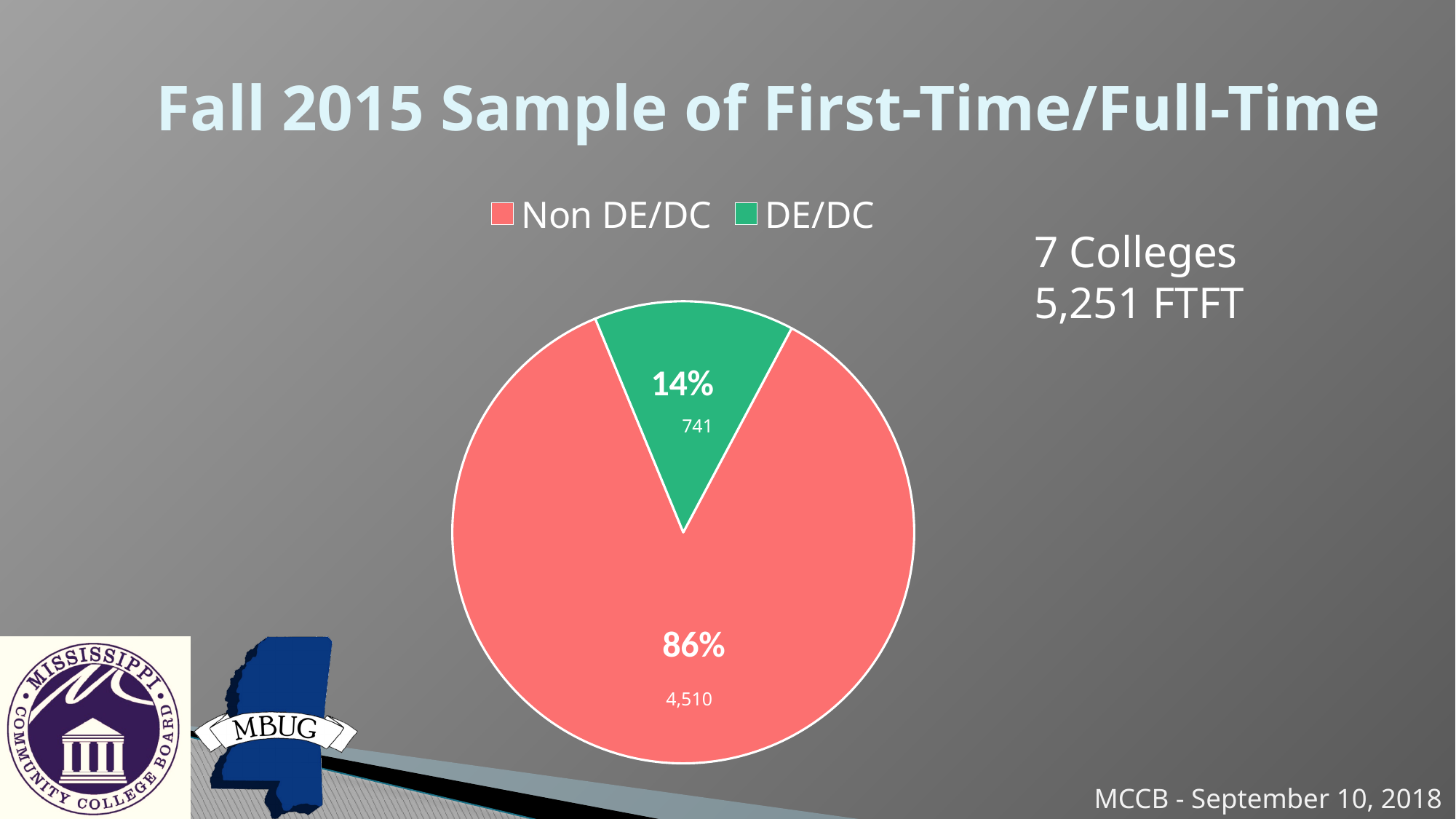
What percentage of the pie is the DE/DC slice? 14% How many slices does the pie chart have? 2 What is the difference between the Non DE/DC count and the DE/DC count? 3,769 Which slice is the largest? Non DE/DC How many entries does the legend list? 2 What colour is the DE/DC slice? green What kind of chart is shown on the slide? pie chart What percentage of the pie is the Non DE/DC slice? 86% What is the count shown for the Non DE/DC slice? 4,510 What is the count shown for the DE/DC slice? 741 Which is larger, the Non DE/DC slice or the DE/DC slice? Non DE/DC Which slice is the smallest? DE/DC